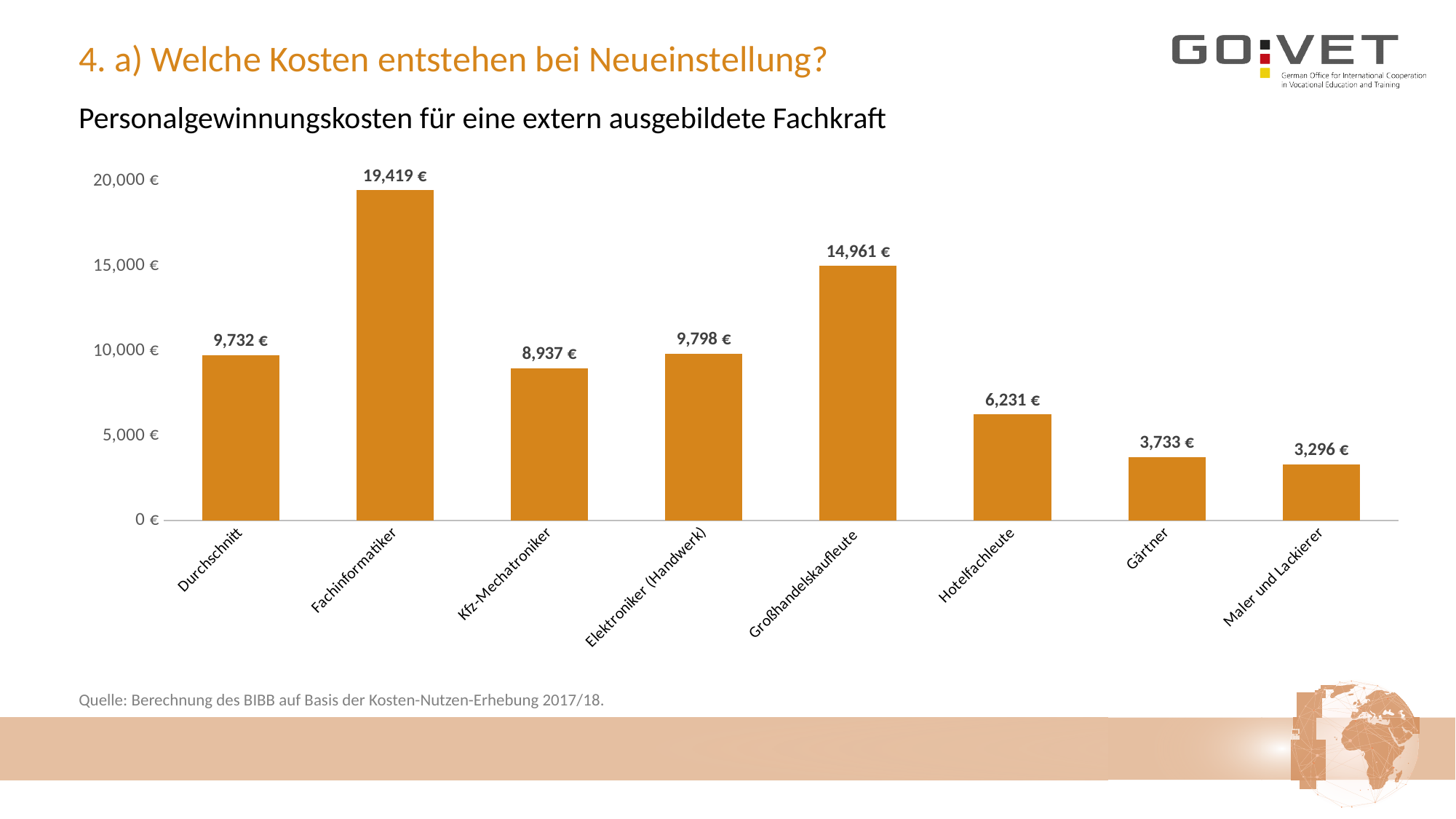
What is the title of the chart? Personalgewinnungskosten für eine extern ausgebildete Fachkraft Which category has the highest value? Fachinformatiker What is the value for Hotelfachleute? 6,231 € Is the value for Großhandelskaufleute greater or less than 10,000 €? greater How many categories are shown on the x axis? 8 What is the difference between the values for Fachinformatiker and Großhandelskaufleute? 4,458 € What is the value for Durchschnitt? 9,732 € What is the value for Fachinformatiker? 19,419 € What is the difference between the values for Gärtner and Maler und Lackierer? 437 € What kind of chart is shown on the slide? bar chart Which is larger, the value for Kfz-Mechatroniker or the value for Elektroniker (Handwerk)? Elektroniker (Handwerk) Which category has the lowest value? Maler und Lackierer